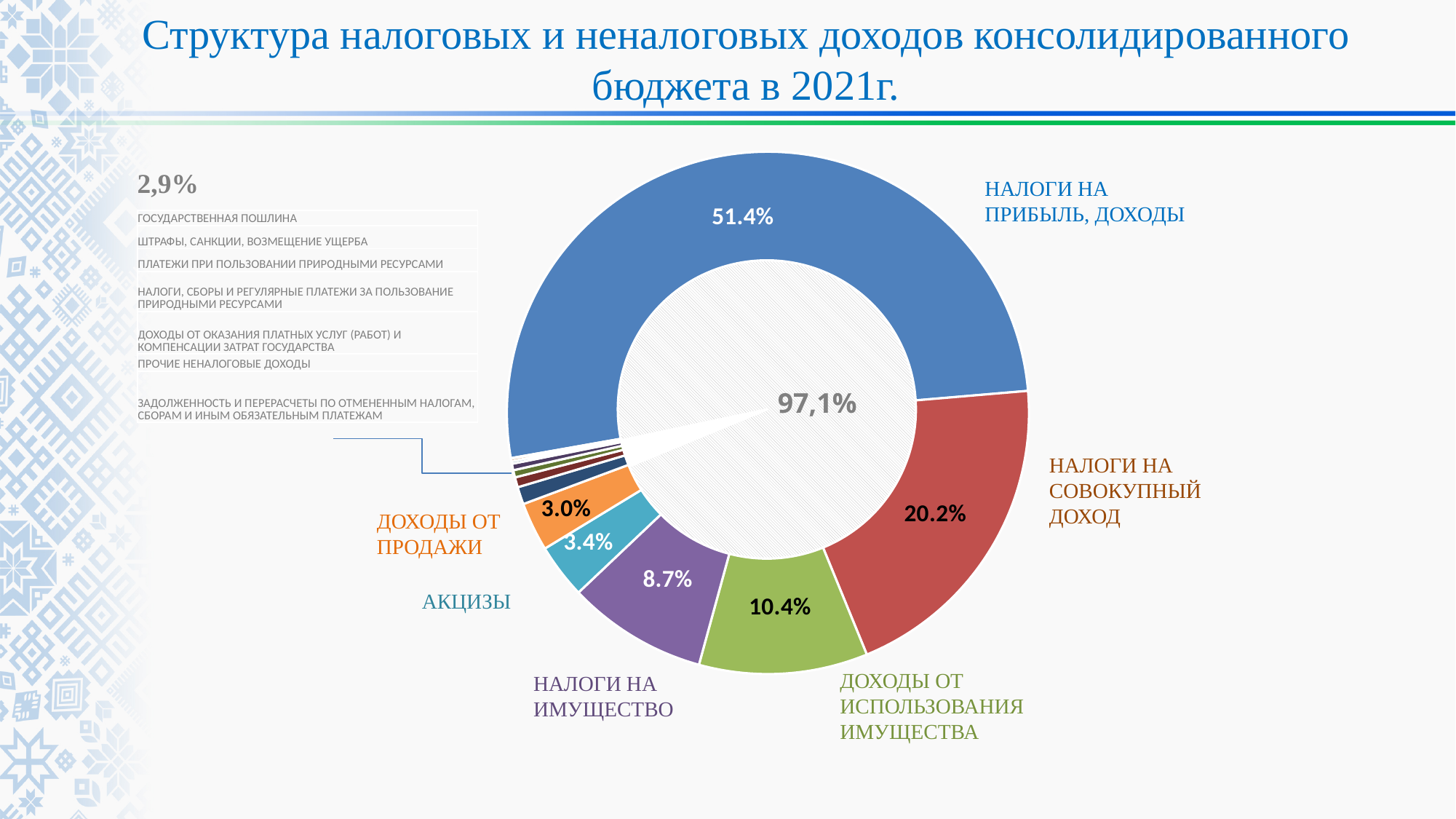
What share of the chart is labelled for НАЛОГИ НА ПРИБЫЛЬ, ДОХОДЫ? 51.4% What share is shown for НАЛОГИ НА СОВОКУПНЫЙ ДОХОД? 20.2% Which category has the largest slice of the chart? НАЛОГИ НА ПРИБЫЛЬ, ДОХОДЫ What share is shown for ДОХОДЫ ОТ ИСПОЛЬЗОВАНИЯ ИМУЩЕСТВА? 10.4% What is the difference in percentage points between НАЛОГИ НА ПРИБЫЛЬ, ДОХОДЫ and НАЛОГИ НА СОВОКУПНЫЙ ДОХОД? 31.2 What share is shown for АКЦИЗЫ? 3.4% What value is printed in the centre of the doughnut chart? 97,1% Which of the six named categories with a printed percentage has the smallest slice? ДОХОДЫ ОТ ПРОДАЖИ What share is shown for ДОХОДЫ ОТ ПРОДАЖИ? 3.0% What share is shown for НАЛОГИ НА ИМУЩЕСТВО? 8.7% Which slice is larger, АКЦИЗЫ or ДОХОДЫ ОТ ПРОДАЖИ? АКЦИЗЫ What kind of chart is shown on the slide? doughnut chart